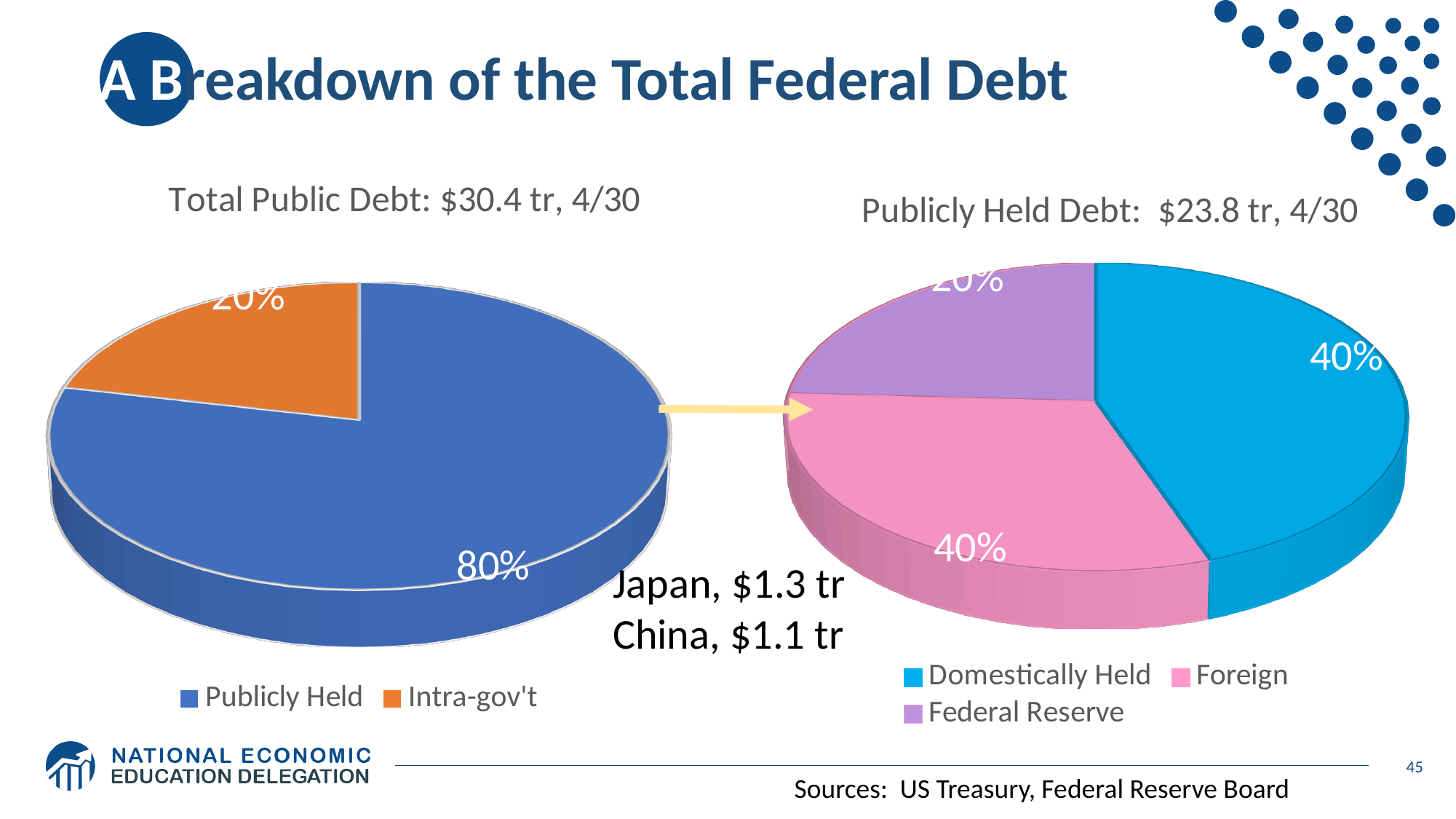
In the 'Publicly Held Debt' chart, how many categories does the legend list? 3 What kind of chart is the 'Total Public Debt' chart on the left? Pie chart In the 'Total Public Debt' chart, what share of the pie is Publicly Held? 80% In the 'Total Public Debt' chart, what is the difference in percentage points between Publicly Held and Intra-gov't? 60 In the 'Total Public Debt' chart, which slice is the largest? Publicly Held In the 'Publicly Held Debt' chart, which slice is the smallest? Federal Reserve In the 'Publicly Held Debt' chart, which is larger, Domestically Held or Federal Reserve? Domestically Held In the 'Total Public Debt' chart, what share of the pie is Intra-gov't? 20% In the 'Publicly Held Debt' chart, what share of the pie is Foreign? 40% What total value is given in the title of the 'Publicly Held Debt' chart on the right? $23.8 tr In the 'Total Public Debt' chart, how many slices does the pie have? 2 In the 'Publicly Held Debt' chart, what share of the pie is Federal Reserve? 20%